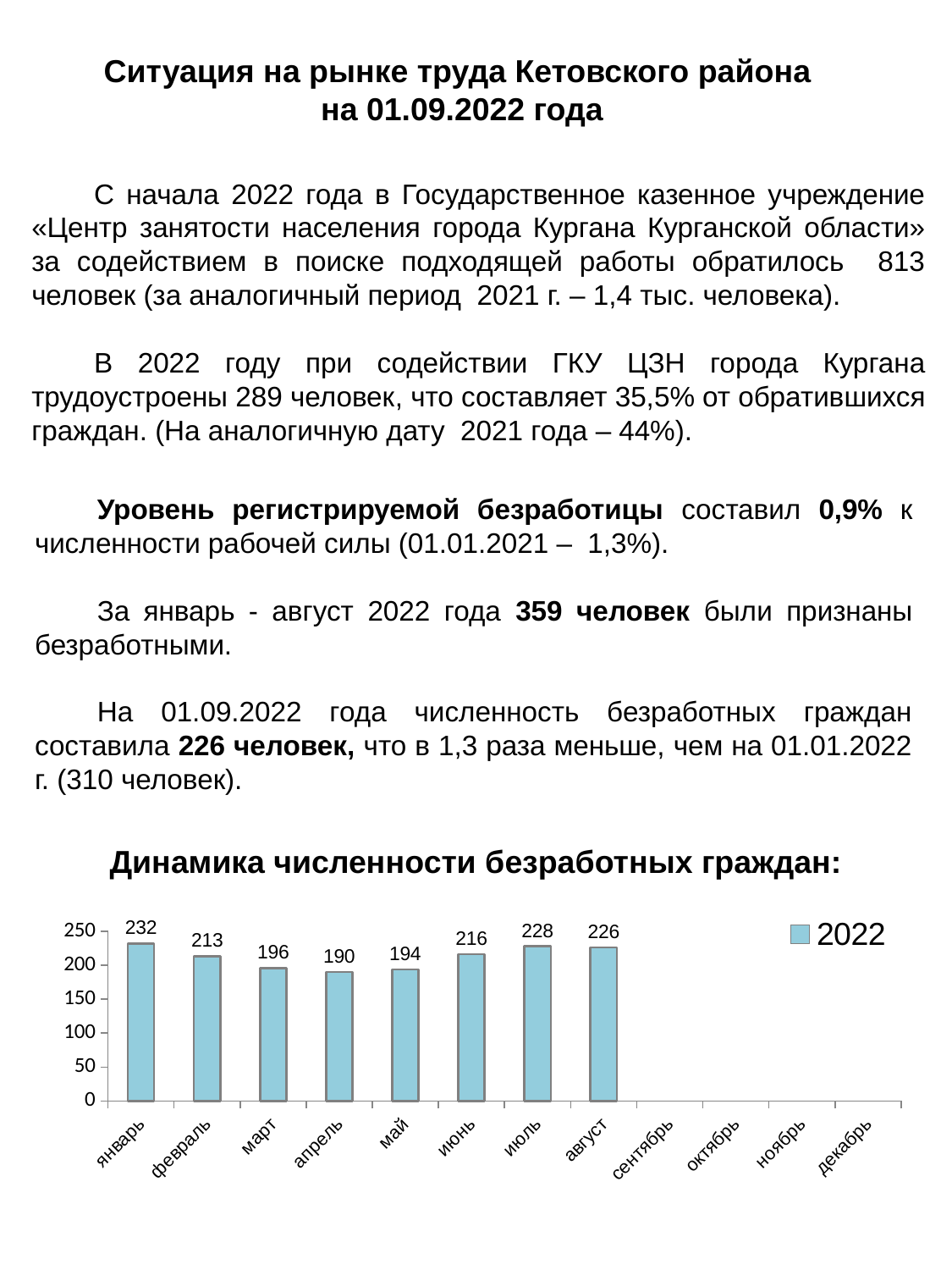
Is the value for март greater or less than 200? less What kind of chart is shown on the slide? bar chart How many series does the legend list? 1 What is the difference between the values for январь and апрель? 42 How many months have a bar plotted in the chart? 8 What is the value for август in the chart? 226 Which month has the highest value in the chart? январь What is the value for январь in the chart 'Динамика численности безработных граждан'? 232 What series name is shown in the chart legend? 2022 Which is larger, the value for июль or the value for август? июль Which month has the lowest value among the plotted bars? апрель What is the value for апрель in the chart? 190